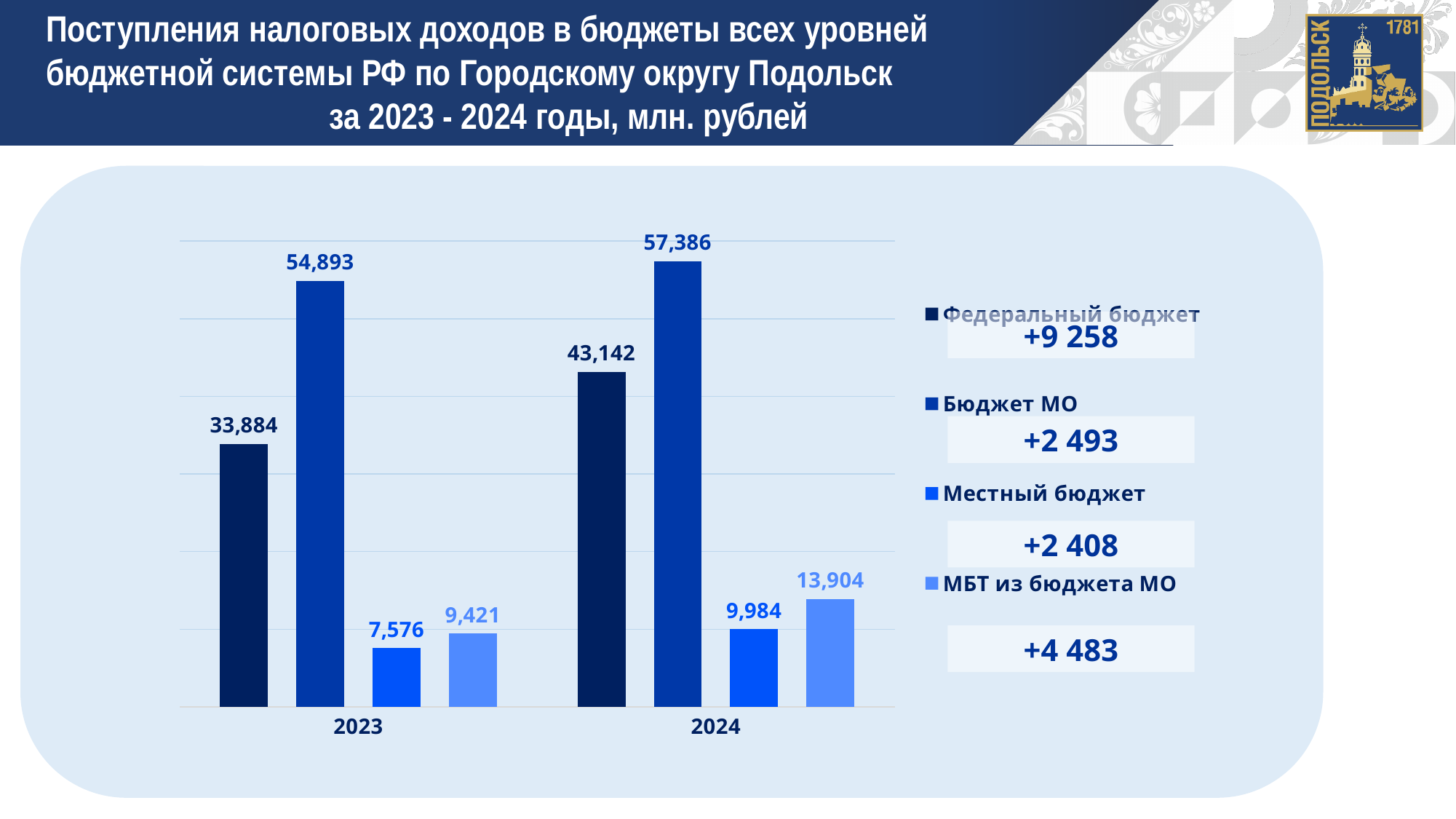
Does the value for Бюджет МО rise or fall from 2023 to 2024? Rise Which is larger: Местный бюджет in 2024 or МБТ из бюджета МО in 2023? Местный бюджет in 2024 What is the difference between the МБТ из бюджета МО values for 2024 and 2023? 4,483 Which series has the lowest value in 2023? Местный бюджет How many series does the legend list? 4 What is the value for Местный бюджет in 2023? 7,576 What is the value for Бюджет МО in 2024? 57,386 What is the value for МБТ из бюджета МО in 2024? 13,904 Which series has the highest value in 2024? Бюджет МО What is the value for Федеральный бюджет in 2023? 33,884 What is the difference between the Федеральный бюджет values for 2024 and 2023? 9,258 What kind of chart is shown on the slide? Bar chart